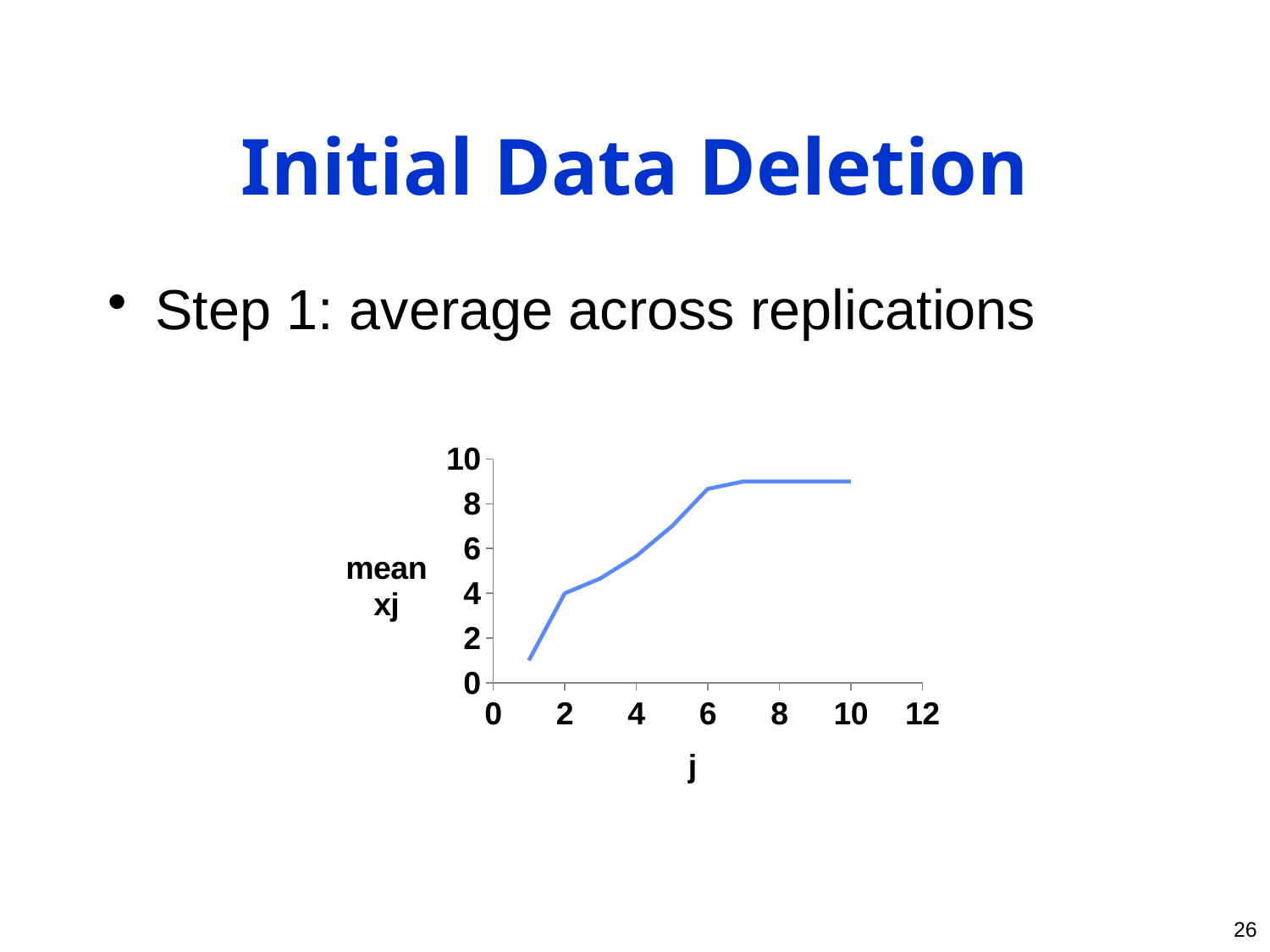
Is the value of mean xj at j = 6 greater or less than 8? greater Does the mean xj value rise or fall as j increases from 1 to 6? rise Is the value of mean xj at j = 10 greater or less than 8? greater Is the value of mean xj at j = 5 greater or less than 6? greater Which has the larger mean xj value, j = 2 or j = 8? j = 8 What is the label of the x axis of the chart? j What is the label of the y axis of the chart? mean xj What kind of chart is shown on the slide? line chart